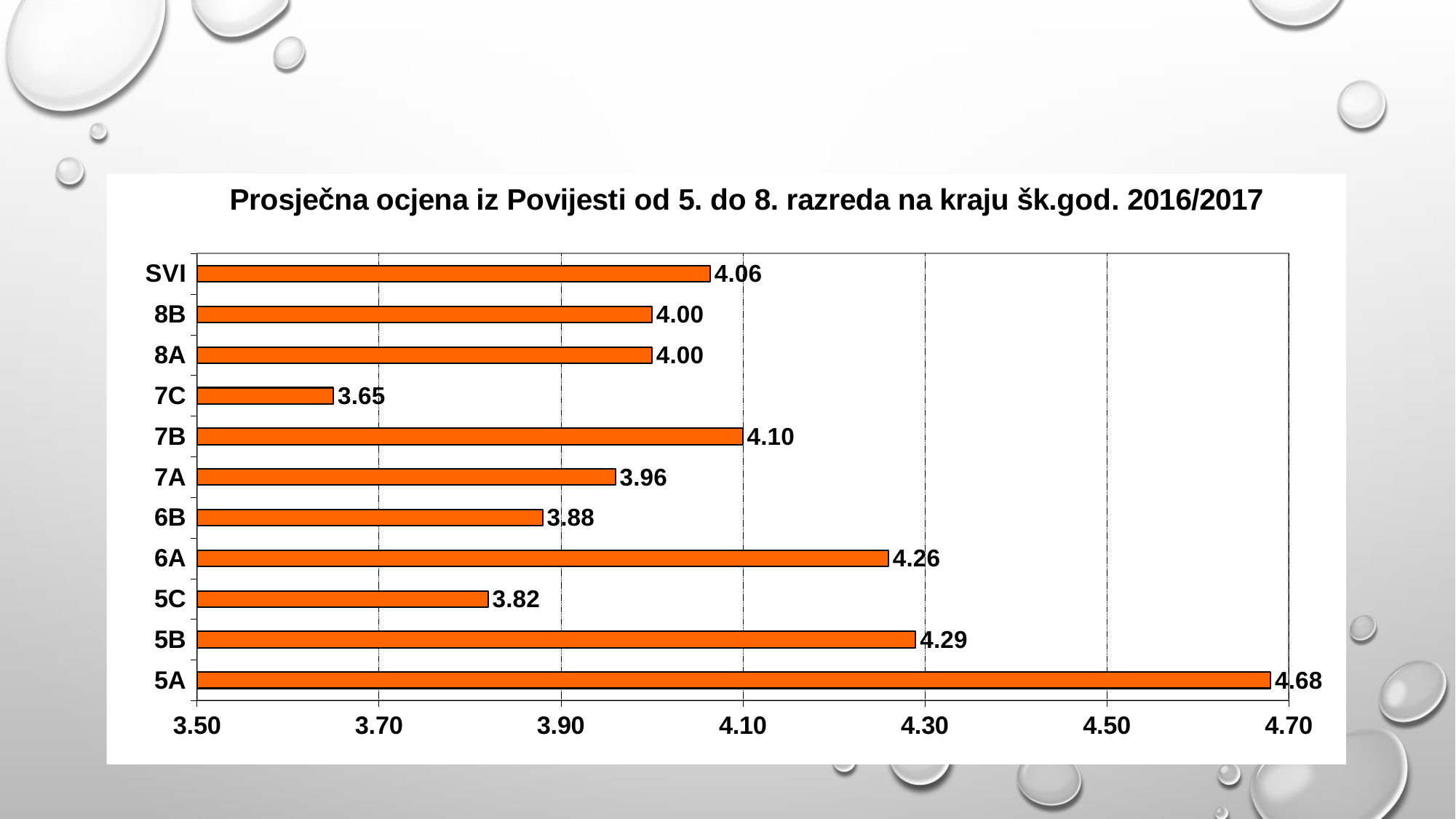
What is the difference between the values for 6A and 6B? 0.38 What is the average History grade for class 5A? 4.68 What kind of chart is shown on the slide? bar chart How many categories are shown on the chart? 11 Which class has the highest average grade? 5A Is the value for 5C greater or less than 3.90? less What is the title of the chart? Prosječna ocjena iz Povijesti od 5. do 8. razreda na kraju šk.god. 2016/2017 Which class has the lowest average grade? 7C What is the difference between the values for 5A and 5B? 0.39 Which has a higher average grade, 7B or 7A? 7B What is the average grade for class 7C? 3.65 What is the value shown for SVI? 4.06